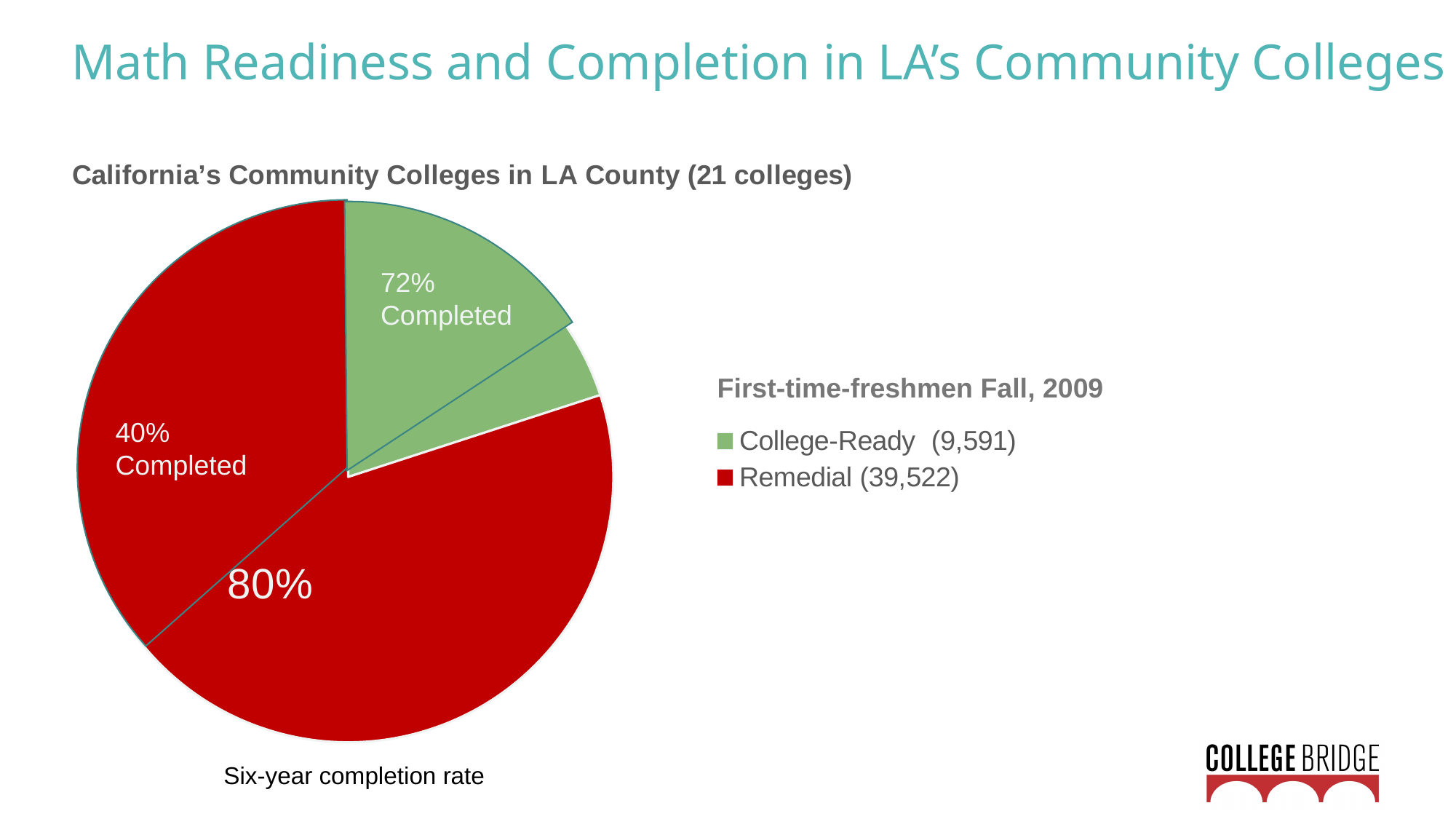
Which category has the larger slice of the pie? Remedial What share of the pie does the Remedial slice represent, as labelled on the chart? 80% What kind of chart is shown on the slide? pie chart What is the title of the pie chart? California's Community Colleges in LA County (21 colleges) How many slices does the pie chart have? 2 What six-year completion rate is labelled on the Remedial slice? 40% How many first-time freshmen are shown as Remedial in the legend? 39,522 What is the difference between the number of Remedial and College-Ready first-time freshmen? 29,931 How many entries does the legend list? 2 Which category has the smaller slice of the pie? College-Ready What six-year completion rate is labelled on the College-Ready slice? 72% How many first-time freshmen are shown as College-Ready in the legend? 9,591